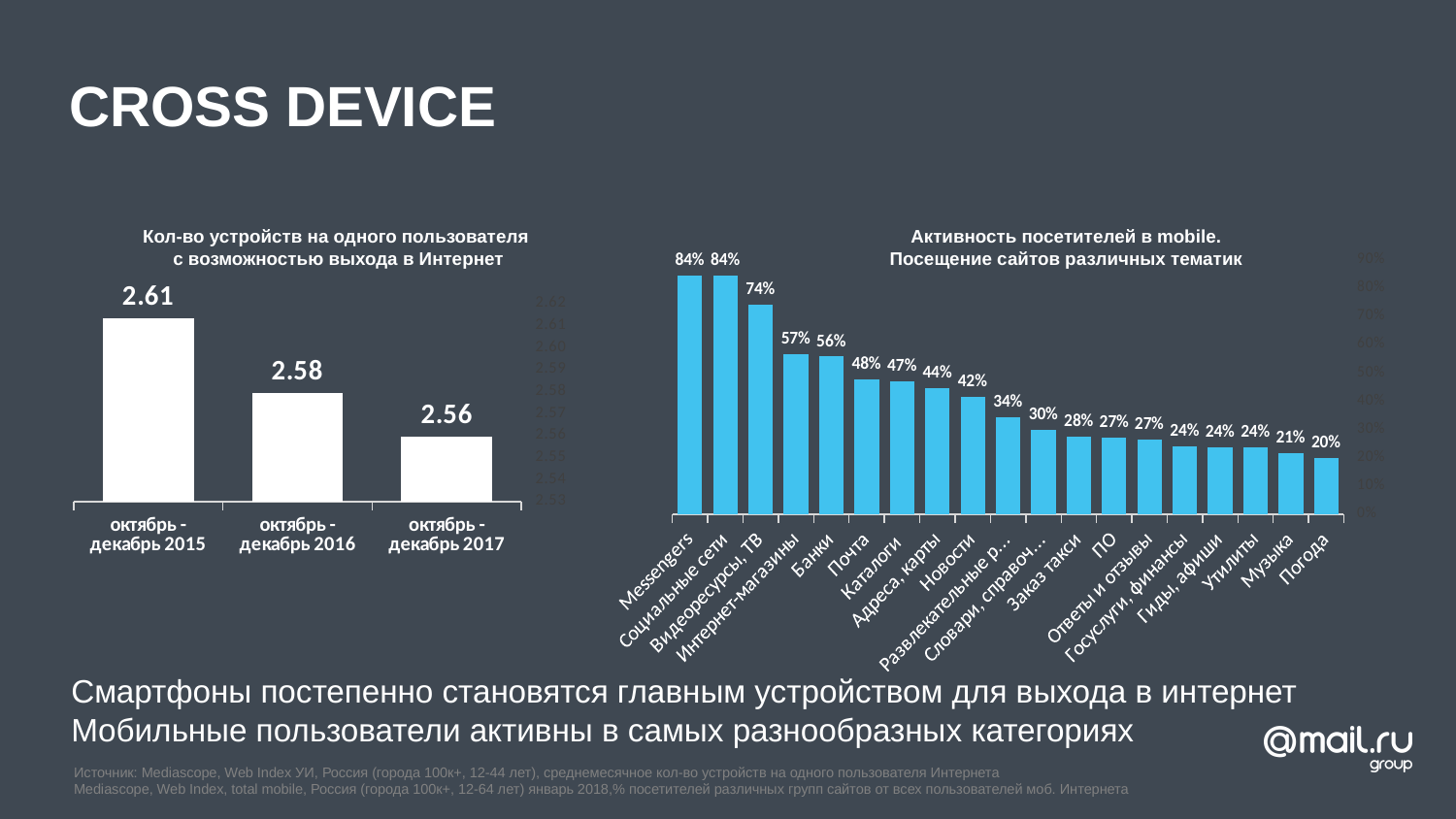
In the left chart (Кол-во устройств на одного пользователя), do the values rise or fall from 2015 to 2017? fall In the left chart (Кол-во устройств на одного пользователя), what is the value for октябрь - декабрь 2015? 2.61 In the right chart (Активность посетителей в mobile), which category has the lowest value? Погода In the right chart (Активность посетителей в mobile), how many categories are plotted? 19 What type of chart is the right chart (Активность посетителей в mobile)? bar chart In the left chart (Кол-во устройств на одного пользователя), what is the value for октябрь - декабрь 2017? 2.56 In the right chart (Активность посетителей в mobile), what is the value for Банки? 56% In the right chart (Активность посетителей в mobile), what is the difference between Видеоресурсы, ТВ and Музыка? 53% In the right chart (Активность посетителей в mobile), which is larger: Почта or Заказ такси? Почта In the left chart (Кол-во устройств на одного пользователя), what is the difference between the 2015 and 2017 values? 0.05 In the left chart (Кол-во устройств на одного пользователя), how many bars are shown? 3 In the right chart (Активность посетителей в mobile), what is the value for Новости? 42%